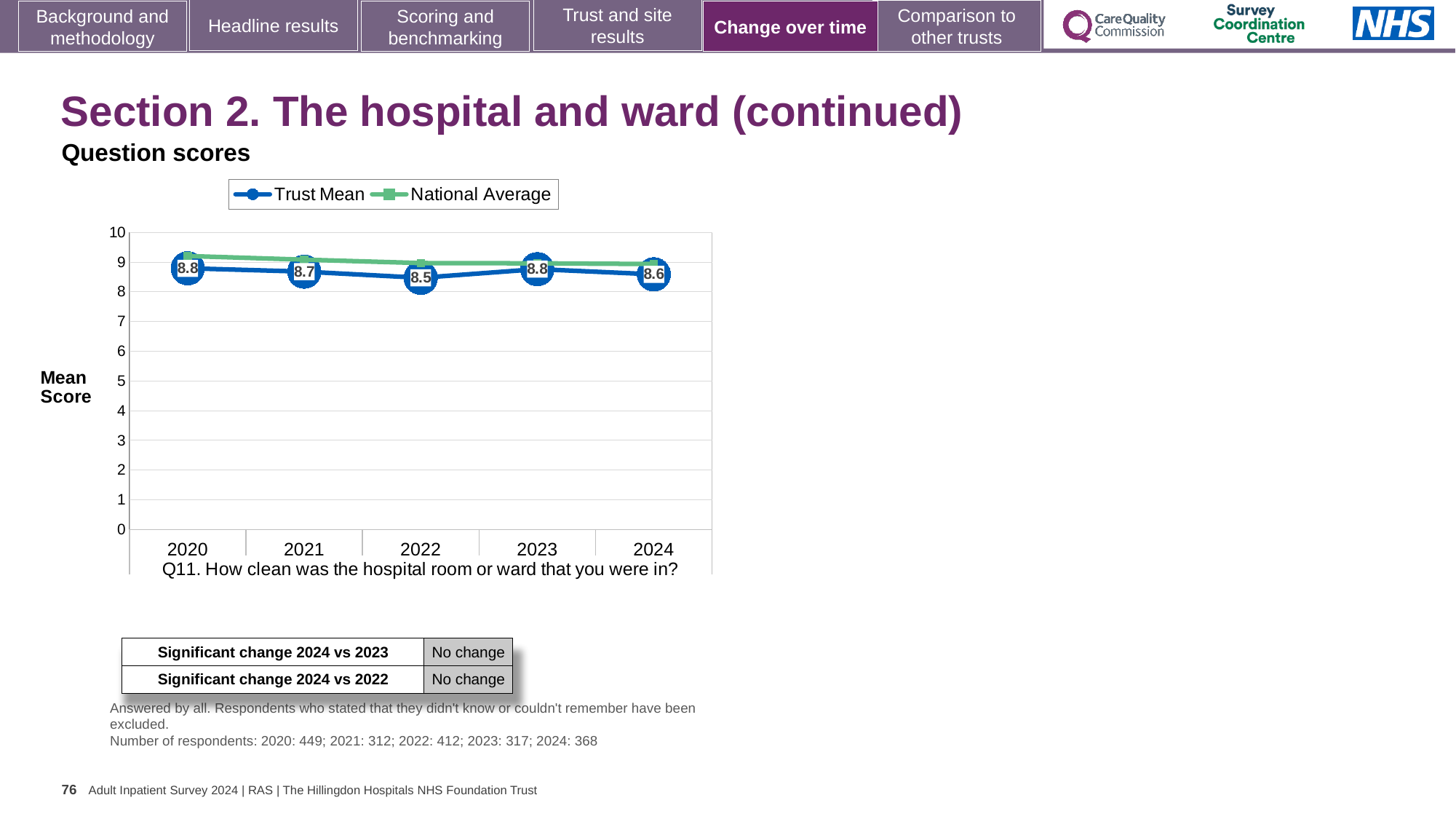
In which year is the Trust Mean lowest? 2022 What is the Trust Mean value for 2021? 8.7 Is the National Average value for 2020 greater or less than 5? greater How many years are shown on the x axis? 5 What kind of chart is shown on the slide? line chart What is the Trust Mean value for 2022? 8.5 In 2022, which series has the higher value, Trust Mean or National Average? National Average Does the Trust Mean rise or fall from 2020 to 2022? fall How many series does the legend list? 2 What is the difference between the Trust Mean in 2020 and in 2022? 0.3 What is the Trust Mean value for 2024? 8.6 Which survey question does the chart show scores for? Q11. How clean was the hospital room or ward that you were in?